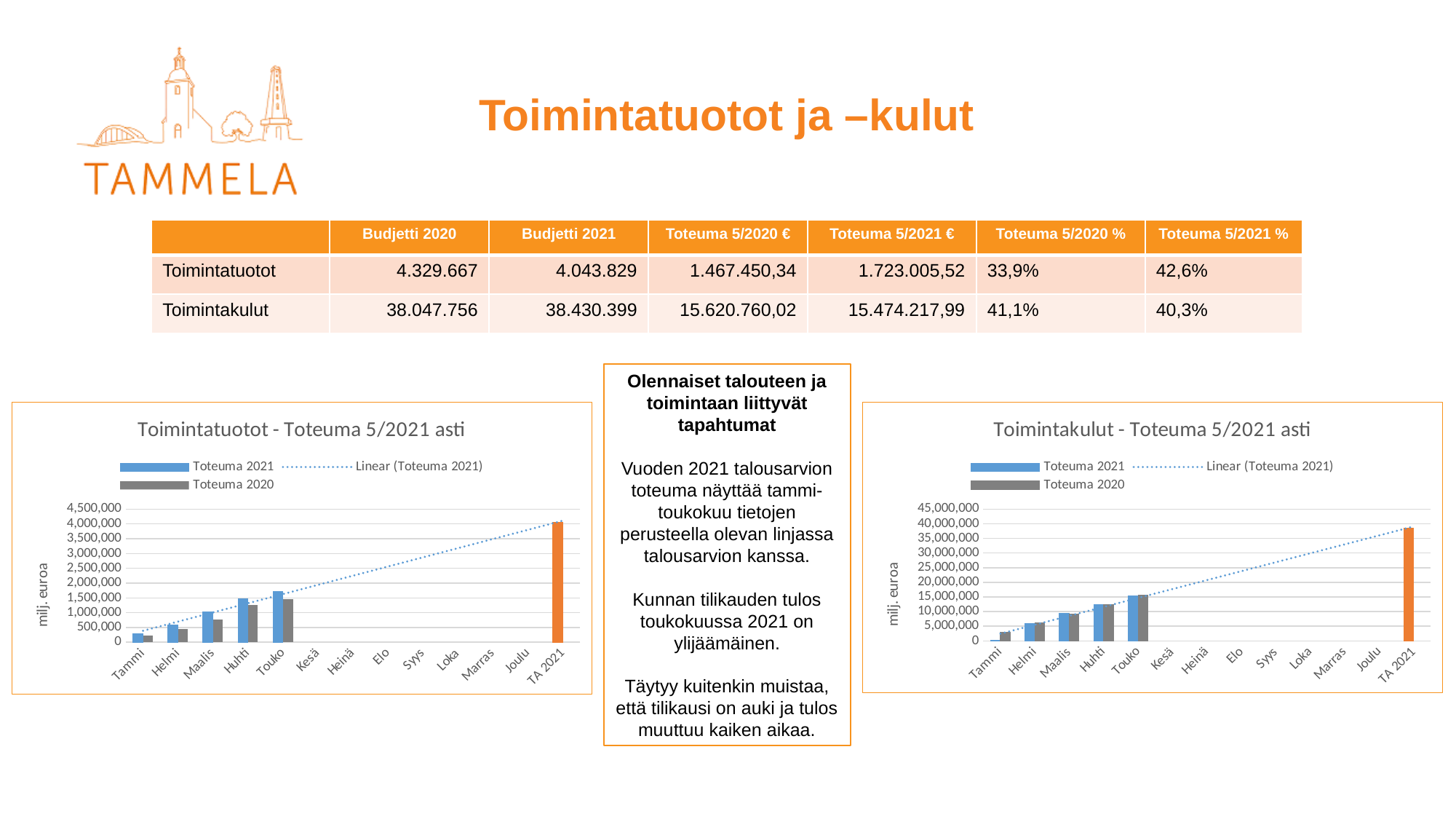
What kind of chart is "Toimintatuotot - Toteuma 5/2021 asti"? bar chart In the "Toimintatuotot - Toteuma 5/2021 asti" chart, which is larger for Huhti: Toteuma 2021 or Toteuma 2020? Toteuma 2021 In the "Toimintakulut - Toteuma 5/2021 asti" chart, is the Toteuma 2021 value for Maalis greater or less than 10,000,000? less In the "Toimintatuotot - Toteuma 5/2021 asti" chart, which month has the lowest Toteuma 2021 value among the months with bars? Tammi In the "Toimintatuotot - Toteuma 5/2021 asti" chart, is the TA 2021 bar greater or less than 3,500,000? greater What is the y-axis label of the "Toimintakulut - Toteuma 5/2021 asti" chart? milj. euroa In the "Toimintakulut - Toteuma 5/2021 asti" chart, is the TA 2021 bar greater or less than 35,000,000? greater How many entries does the legend of the "Toimintatuotot - Toteuma 5/2021 asti" chart list? 3 How many categories are on the x axis of the "Toimintakulut - Toteuma 5/2021 asti" chart? 13 In the "Toimintakulut - Toteuma 5/2021 asti" chart, do the Toteuma 2021 values rise or fall from Tammi to Touko? rise In the "Toimintatuotot - Toteuma 5/2021 asti" chart, which month has the highest Toteuma 2021 value? Touko